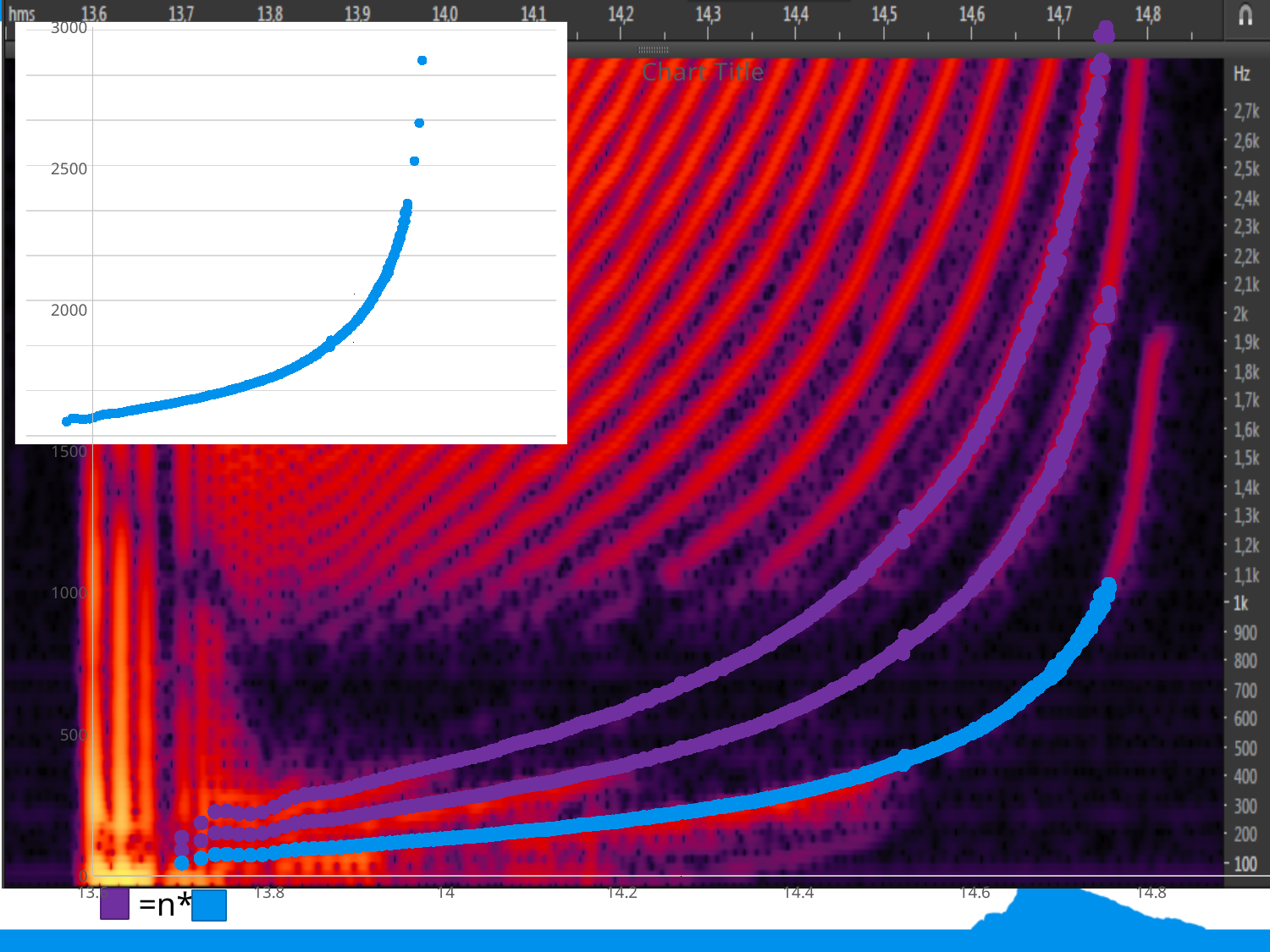
In the large chart, is the highest point of the upper purple series greater or less than 2500? greater In the large chart, do the plotted values rise or fall as the x axis increases from 13.6 to 14.8? Rise In the inset chart at the top left, do the values rise or fall from left to right? Rise What is the title shown on the large chart? Chart Title In the large chart, at x = 14.6, is the purple series or the blue series higher? Purple In the large chart, which series reaches the highest value: the purple series or the blue series? Purple In the inset chart at the top left, is the highest point greater or less than 2500? greater In the inset chart at the top left, is the leftmost point greater or less than 2000? less What kind of chart is the large chart overlaid on the spectrogram? Scatter chart What colours are used for the plotted series in the large chart? Purple and blue